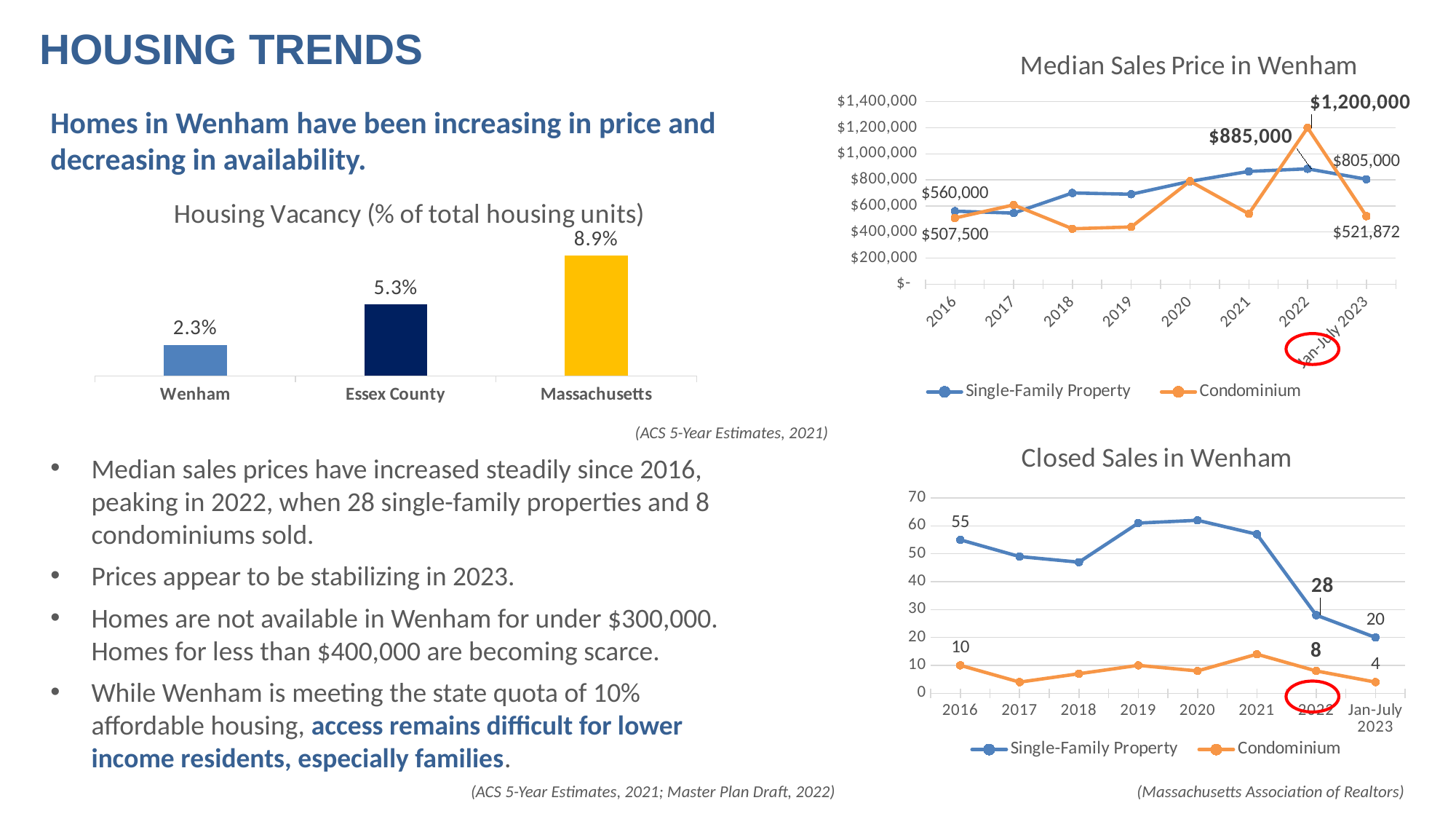
In the Closed Sales in Wenham chart, what is the difference between single-family and condominium closed sales in 2022? 20 In the Housing Vacancy chart, what is the vacancy rate for Wenham? 2.3% In the Closed Sales in Wenham chart, how many single-family properties were sold in 2016? 55 In the Median Sales Price in Wenham chart, what was the median condominium price in 2022? $1,200,000 In the Median Sales Price in Wenham chart, which series had the higher value in 2022, Single-Family Property or Condominium? Condominium In the Housing Vacancy chart, which category has the highest vacancy rate? Massachusetts In the Housing Vacancy chart, what is the difference between the Massachusetts and Wenham vacancy rates? 6.6 percentage points In the Median Sales Price in Wenham chart, is the single-family property value for 2018 greater or less than $600,000? greater In the Median Sales Price in Wenham chart, what was the median single-family property price in 2016? $560,000 What kind of chart is the Housing Vacancy chart? Bar chart In the Closed Sales in Wenham chart, how many time periods are plotted on the x axis? 8 How many series does the legend of the Median Sales Price in Wenham chart list? 2